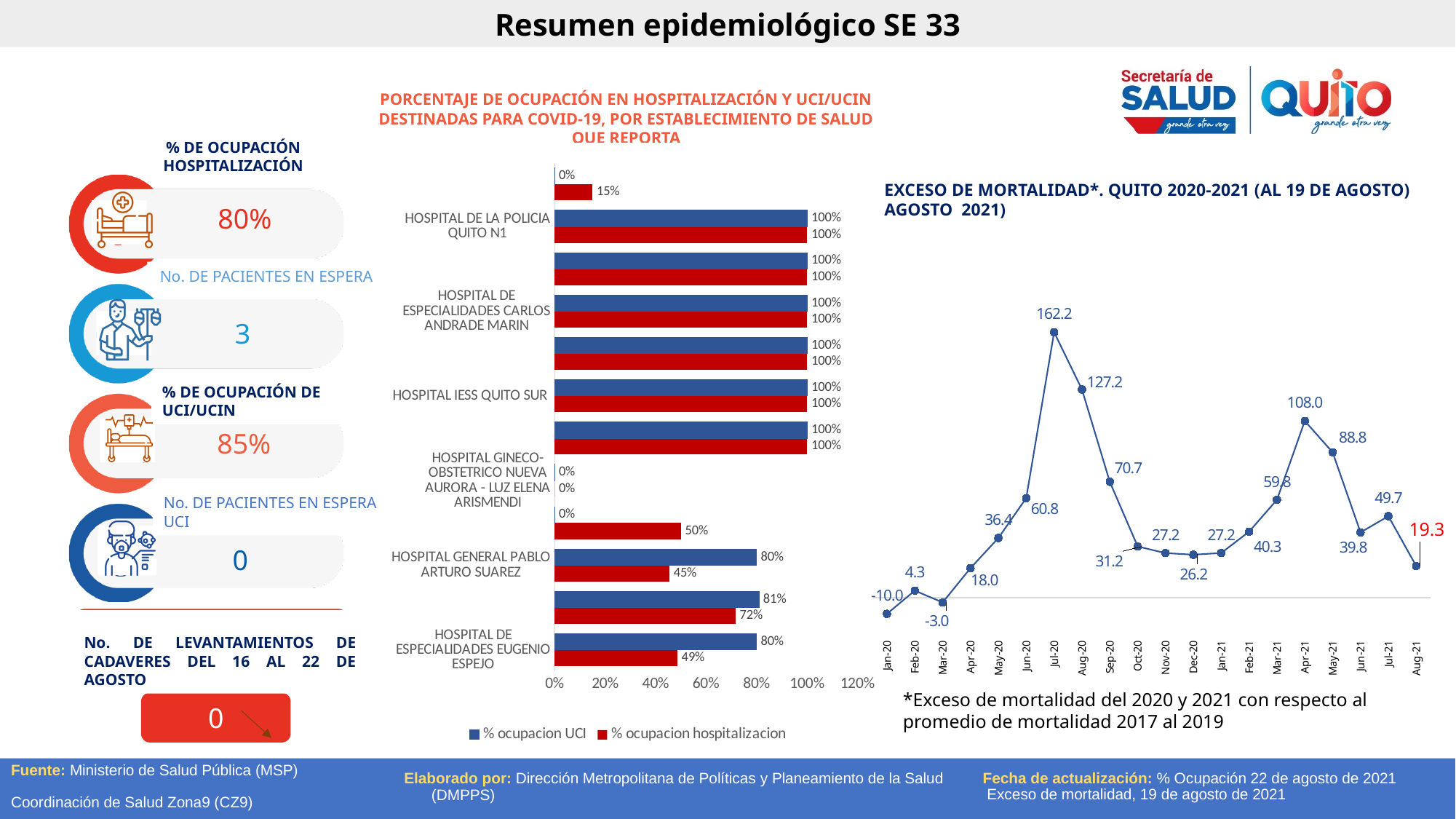
In the 'PORCENTAJE DE OCUPACIÓN' bar chart, what colour represents '% ocupacion UCI' in the legend? blue In the line chart 'EXCESO DE MORTALIDAD', which month has the lowest value? Jan-20 How many data points are plotted in the line chart 'EXCESO DE MORTALIDAD'? 20 What kind of chart is the 'PORCENTAJE DE OCUPACIÓN EN HOSPITALIZACIÓN Y UCI/UCIN' chart? bar chart In the line chart 'EXCESO DE MORTALIDAD', what is the difference between the values for Jul-20 and Aug-20? 35.0 In the line chart 'EXCESO DE MORTALIDAD', what is the value for Jul-20? 162.2 In the line chart 'EXCESO DE MORTALIDAD', what is the value for Aug-21? 19.3 In the line chart 'EXCESO DE MORTALIDAD', which is larger, the value for Apr-21 or May-21? Apr-21 In the line chart 'EXCESO DE MORTALIDAD', do the values rise or fall from Jul-20 to Dec-20? fall In the 'PORCENTAJE DE OCUPACIÓN' bar chart, what is the % ocupacion hospitalizacion for HOSPITAL DE ESPECIALIDADES EUGENIO ESPEJO? 49% How many series does the legend of the 'PORCENTAJE DE OCUPACIÓN' bar chart list? 2 In the line chart 'EXCESO DE MORTALIDAD', which month has the highest value? Jul-20